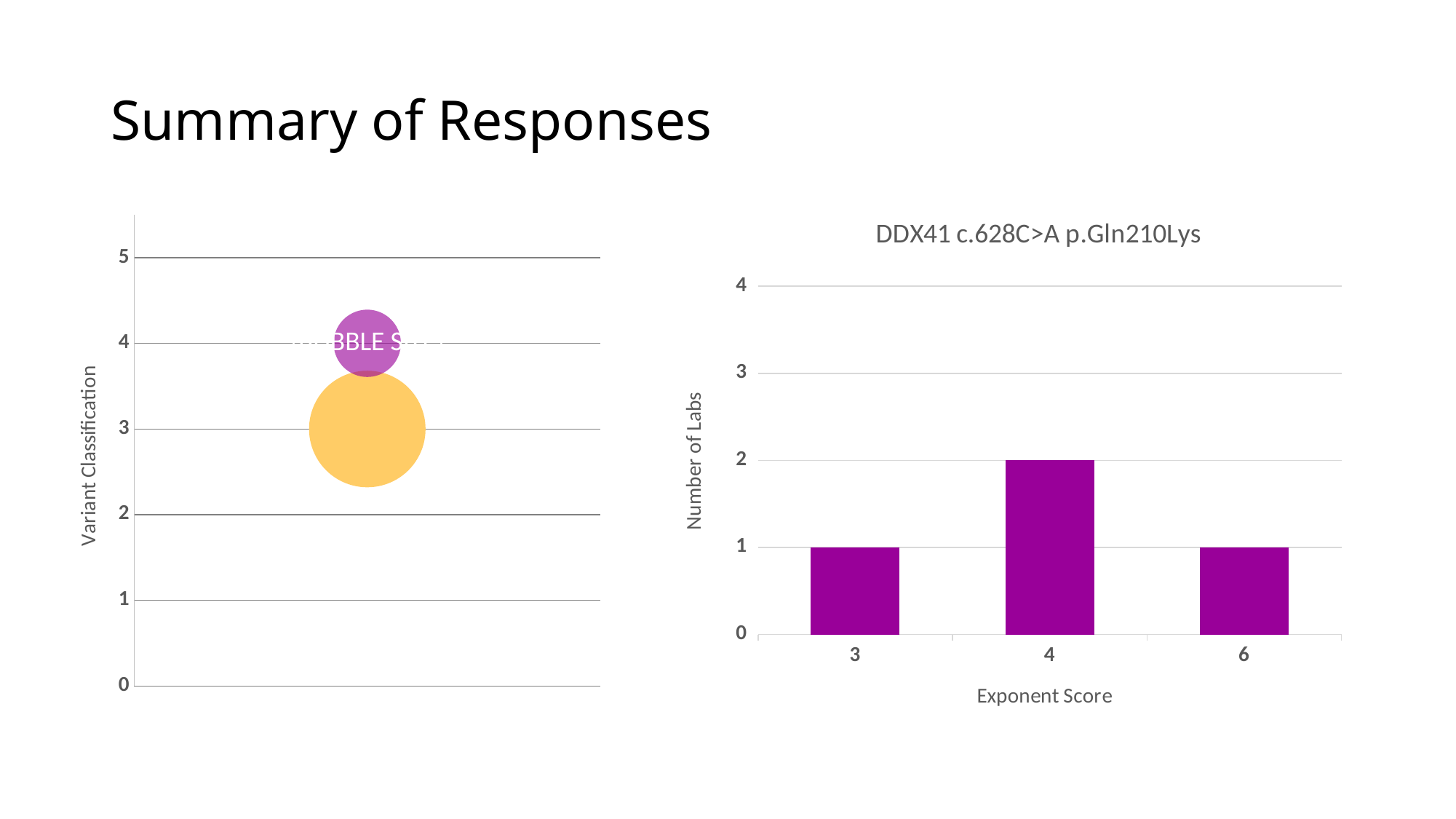
In the bubble chart on the left of the slide, what Variant Classification value is the orange bubble centred on? 3 In the chart titled "DDX41 c.628C>A p.Gln210Lys", what is the number of labs for an Exponent Score of 4? 2 In the chart titled "DDX41 c.628C>A p.Gln210Lys", what is the difference in number of labs between Exponent Score 4 and Exponent Score 3? 1 In the chart titled "DDX41 c.628C>A p.Gln210Lys", what is the number of labs for an Exponent Score of 3? 1 In the chart titled "DDX41 c.628C>A p.Gln210Lys", which has more labs: Exponent Score 4 or Exponent Score 6? Exponent Score 4 In the bubble chart on the left of the slide, what Variant Classification value is the purple bubble centred on? 4 In the chart titled "DDX41 c.628C>A p.Gln210Lys", how many Exponent Score categories are shown on the x axis? 3 In the chart titled "DDX41 c.628C>A p.Gln210Lys", what is the total number of labs across all three Exponent Scores? 4 In the chart titled "DDX41 c.628C>A p.Gln210Lys", which Exponent Score has the highest number of labs? 4 What kind of chart is the chart titled "DDX41 c.628C>A p.Gln210Lys"? Bar chart In the chart titled "DDX41 c.628C>A p.Gln210Lys", what is the number of labs for an Exponent Score of 6? 1 In the chart titled "DDX41 c.628C>A p.Gln210Lys", what is the label of the y axis? Number of Labs